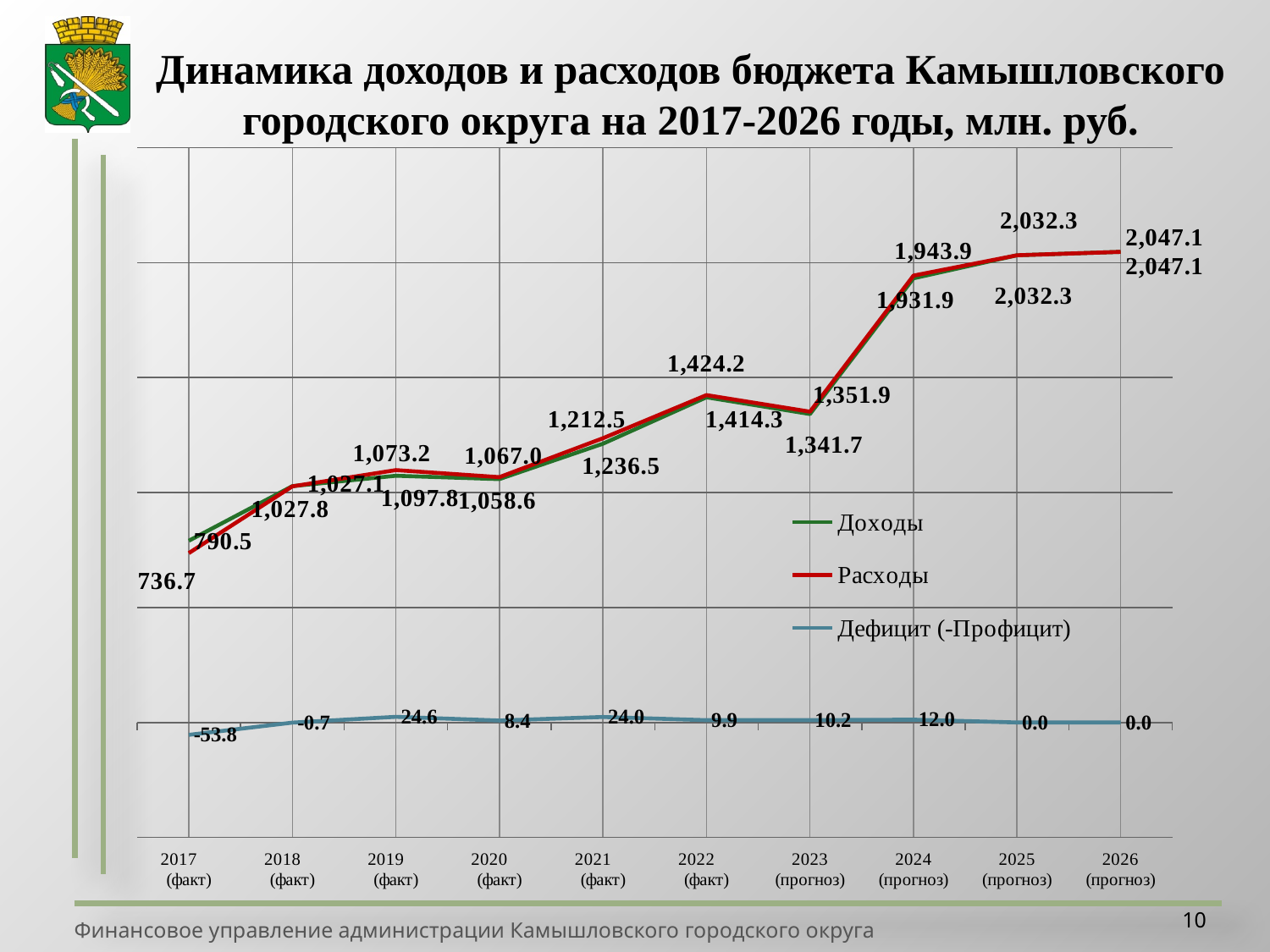
How many series does the legend list? 3 What type of chart is shown on the slide? line chart In which year is Дефицит (-Профицит) highest? 2019 (факт) Do the Расходы values generally rise or fall from 2017 to 2026? rise What is the difference between Дефицит (-Профицит) in 2019 (факт) and 2021 (факт)? 0.6 Which is larger, Дефицит (-Профицит) in 2024 (прогноз) or in 2023 (прогноз)? 2024 (прогноз) What is the value of Расходы for 2025 (прогноз)? 2,032.3 What is the value of Дефицит (-Профицит) for 2019 (факт)? 24.6 What is the value of Дефицит (-Профицит) for 2017 (факт)? -53.8 How many years are plotted along the x axis? 10 In which year is Дефицит (-Профицит) lowest? 2017 (факт) What is the value of Доходы for 2026 (прогноз)? 2,047.1